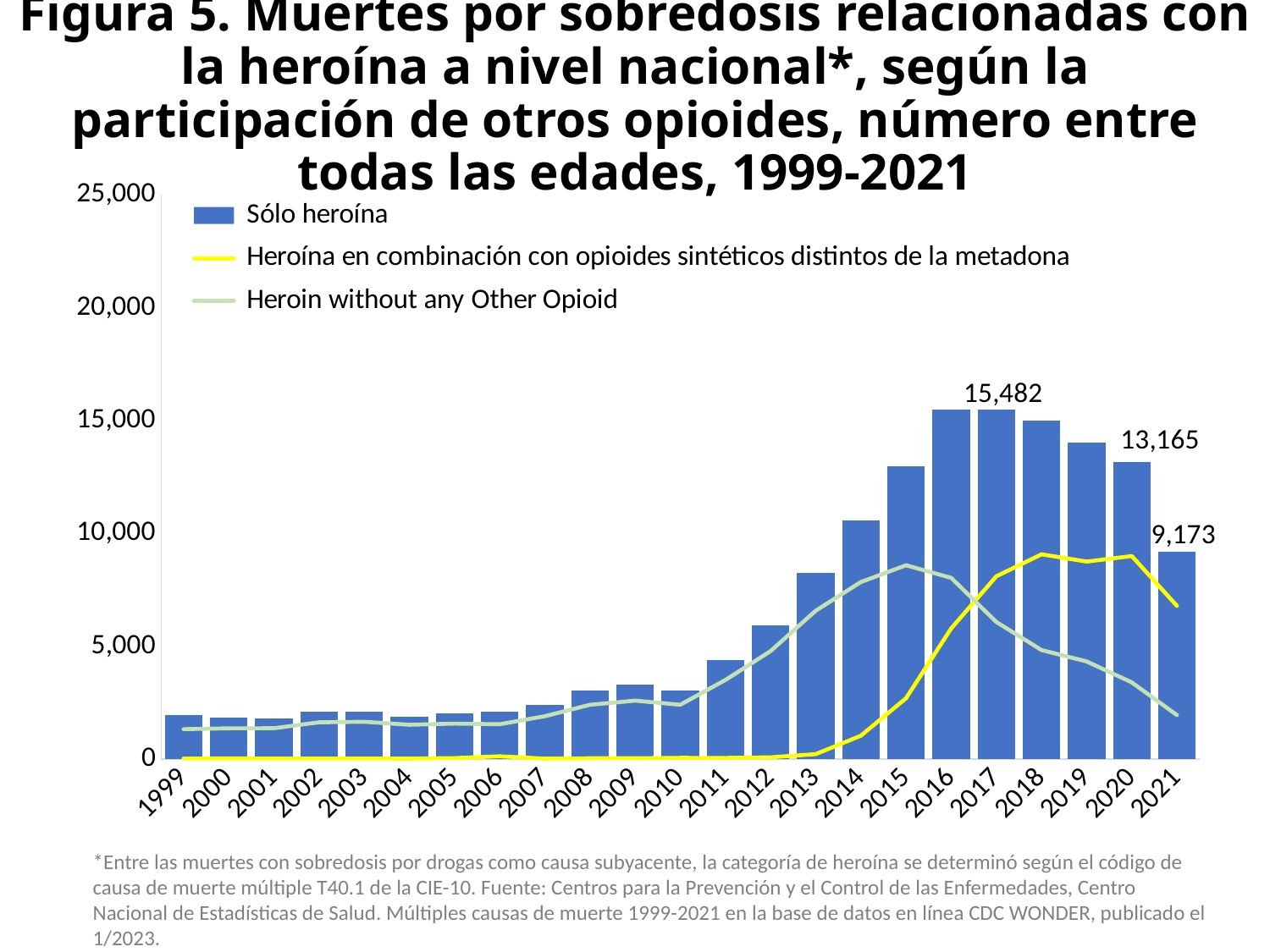
Is the Sólo heroína value for 2011 greater or less than 5,000? less What is the difference between the Sólo heroína values for 2020 and 2021? 3,992 What is the value of the Sólo heroína bar for 2017? 15,482 How many years are shown on the x axis? 23 How many series does the legend list? 3 What is the difference between the Sólo heroína values for 2017 and 2020? 2,317 What kind of chart is used to show the Sólo heroína series? bar chart Do the Sólo heroína bars rise or fall from 2017 to 2021? fall Which year has the larger Sólo heroína value, 2020 or 2021? 2020 What is the value of the Sólo heroína bar for 2020? 13,165 Is the Sólo heroína value for 2014 greater or less than 10,000? greater What is the value of the Sólo heroína bar for 2021? 9,173